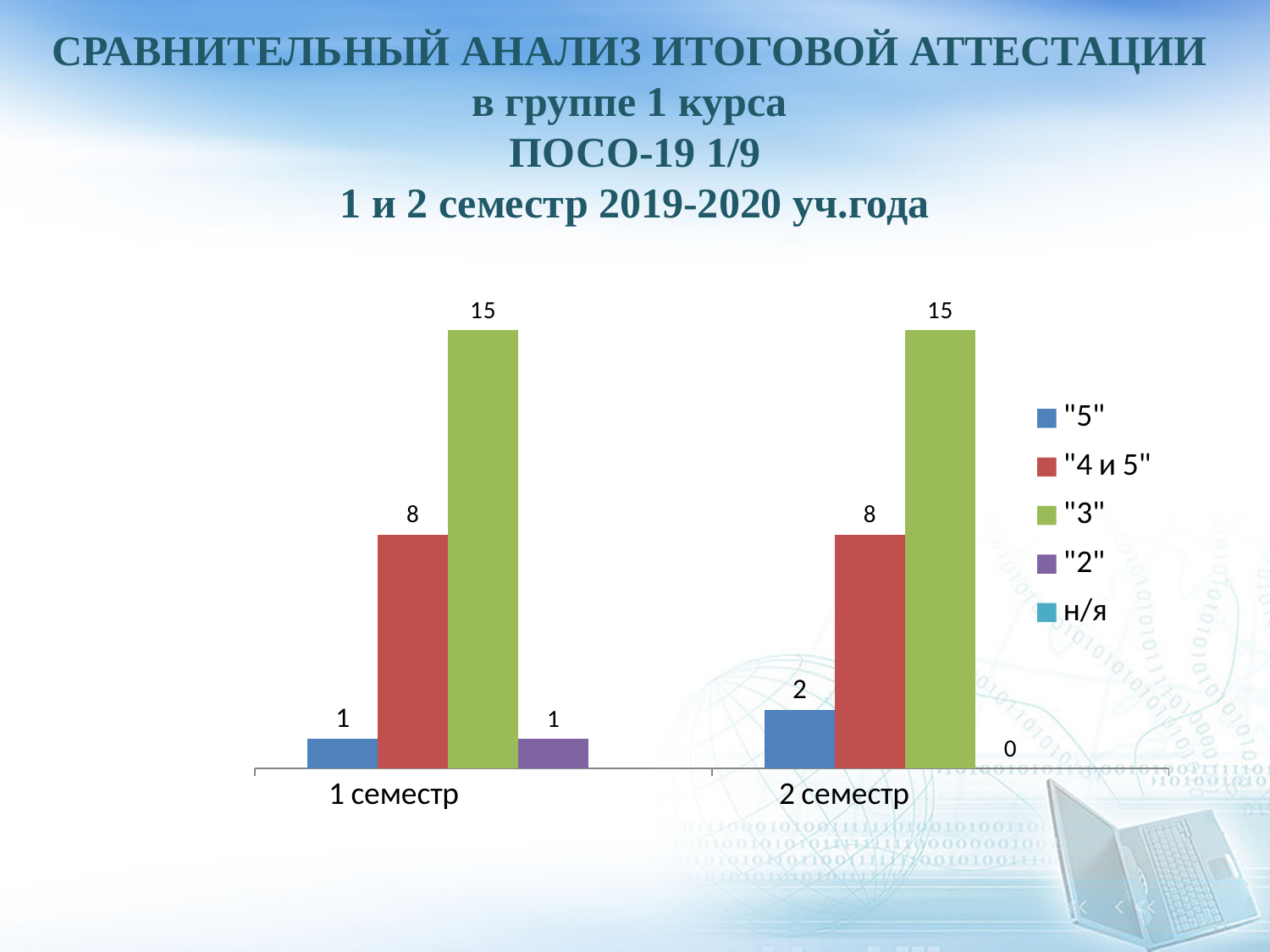
How many categories are shown on the x axis? 2 What is the value for "4 и 5" in 2 семестр? 8 How many series does the legend list? 5 Which series has the highest value in 1 семестр? "3" Which category labels appear on the x axis? 1 семестр, 2 семестр What is the difference between the "3" and "4 и 5" values in 2 семестр? 7 What is the value for "2" in 1 семестр? 1 What is the value for "5" in 2 семестр? 2 What is the value for "2" in 2 семестр? 0 What type of chart is shown on the slide? bar chart Which is larger: the "5" value in 1 семестр or the "5" value in 2 семестр? 2 семестр What is the value for "3" in 1 семестр? 15